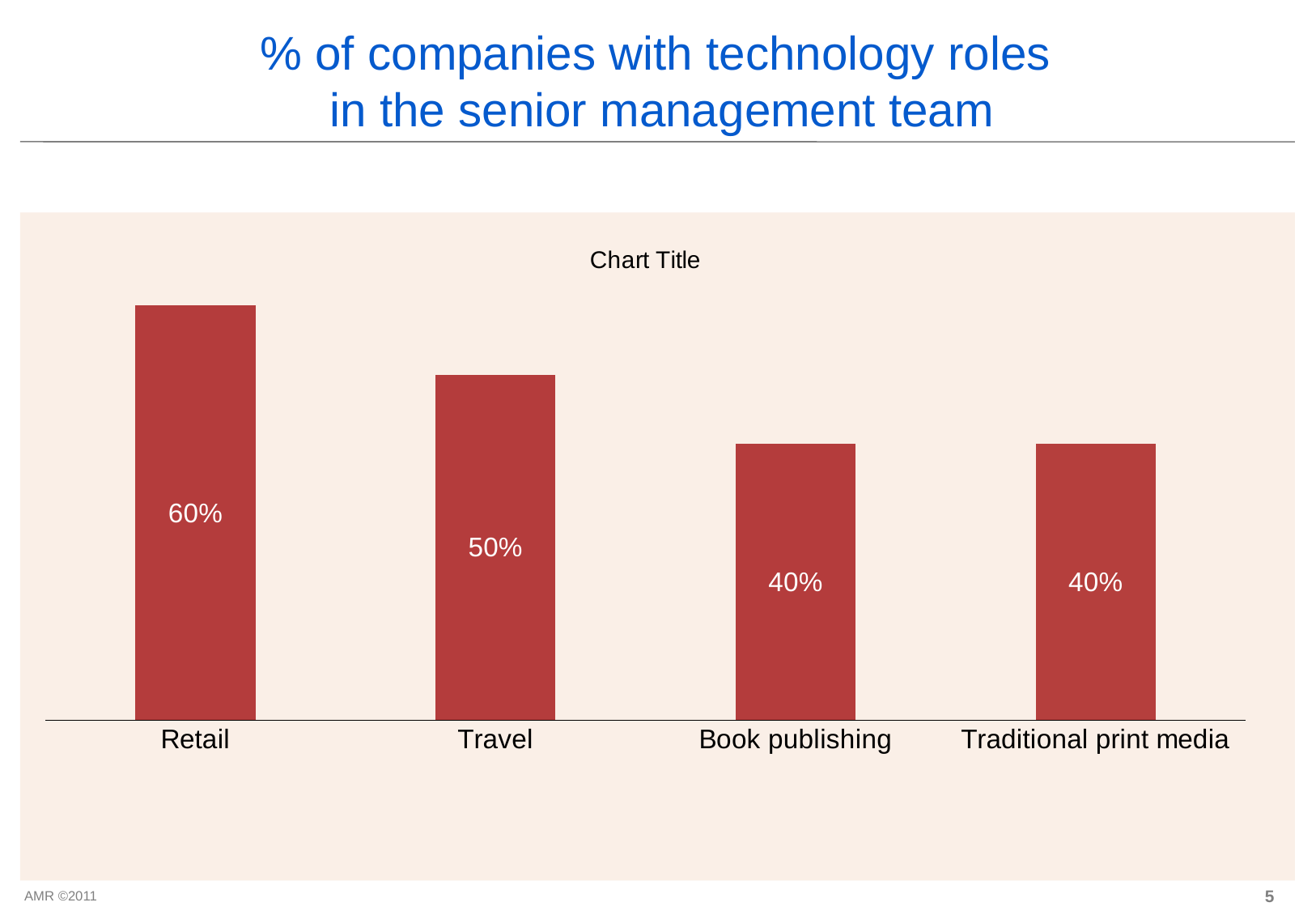
What is the value for Retail? 60% Do the values rise or fall from left to right across the categories? Fall Which category has the highest value? Retail What is the value for Traditional print media? 40% What is the difference between the values for Retail and Book publishing? 20% What is the difference between the values for Retail and Travel? 10% What is the value for Travel? 50% How many categories are shown in the chart? 4 What kind of chart is shown on the slide? Bar chart What is the value for Book publishing? 40% Which is larger, the value for Travel or the value for Traditional print media? Travel What is the title of the slide? % of companies with technology roles in the senior management team